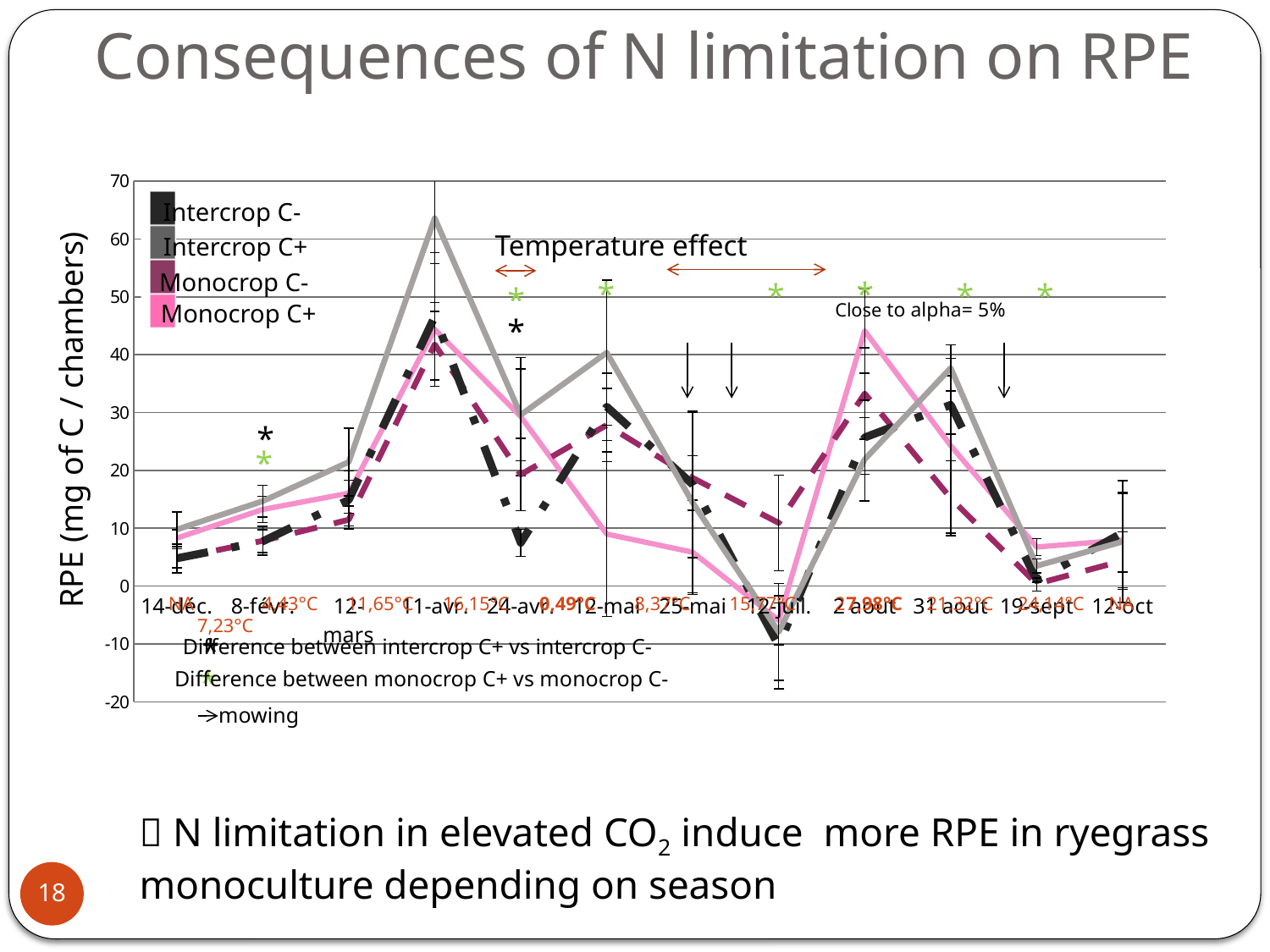
At which date does Intercrop C+ reach its highest value? 11-avr. Is the value for Intercrop C- at 12-juil. greater or less than 0? less At which date does Intercrop C- reach its lowest value? 12-juil. Does Intercrop C+ rise or fall from 14-déc. to 11-avr.? rise Is the value for Intercrop C+ at 11-avr. greater or less than 50? greater Which colour represents Monocrop C+ in the legend? pink What kind of chart is shown on the slide? line chart How many dates are shown along the x axis? 12 At 11-avr., which is larger: Intercrop C+ or Monocrop C+? Intercrop C+ How many series does the legend list? 4 Is the value for Monocrop C+ at 12-mai greater or less than 20? less What is the label of the y axis? RPE (mg of C / chambers)